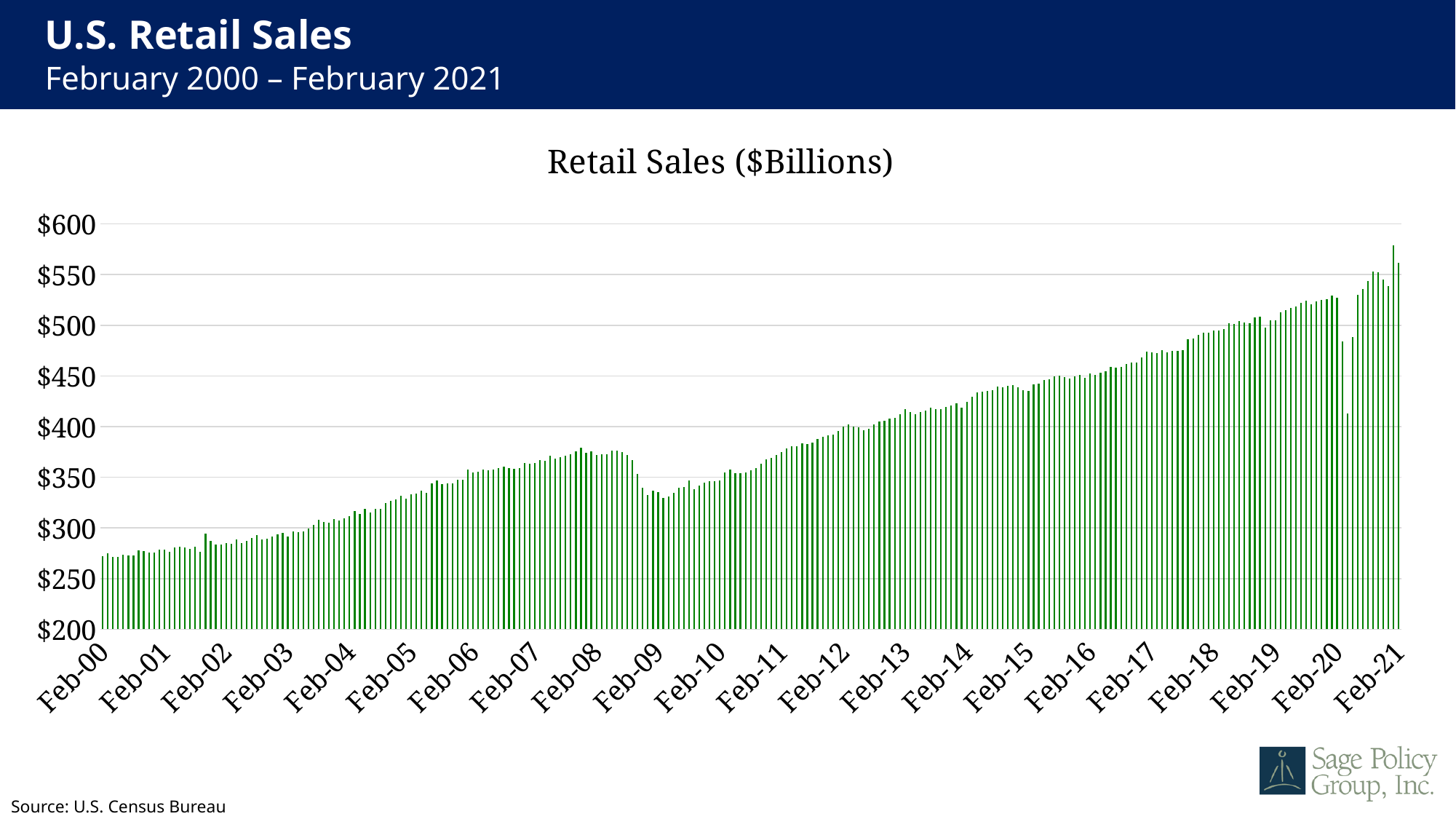
How many year labels are shown on the x axis? 22 Is the value for Feb-05 greater or less than $300? greater Is the value for Feb-15 greater or less than $400? greater What is the title of the chart? Retail Sales ($Billions) Is the value for Feb-09 greater or less than $350? less What kind of chart is shown on the slide? bar chart Overall, do retail sales rise or fall from Feb-00 to Feb-21? rise What source is cited for the chart data? U.S. Census Bureau Which is larger, the value for Feb-08 or the value for Feb-09? Feb-08